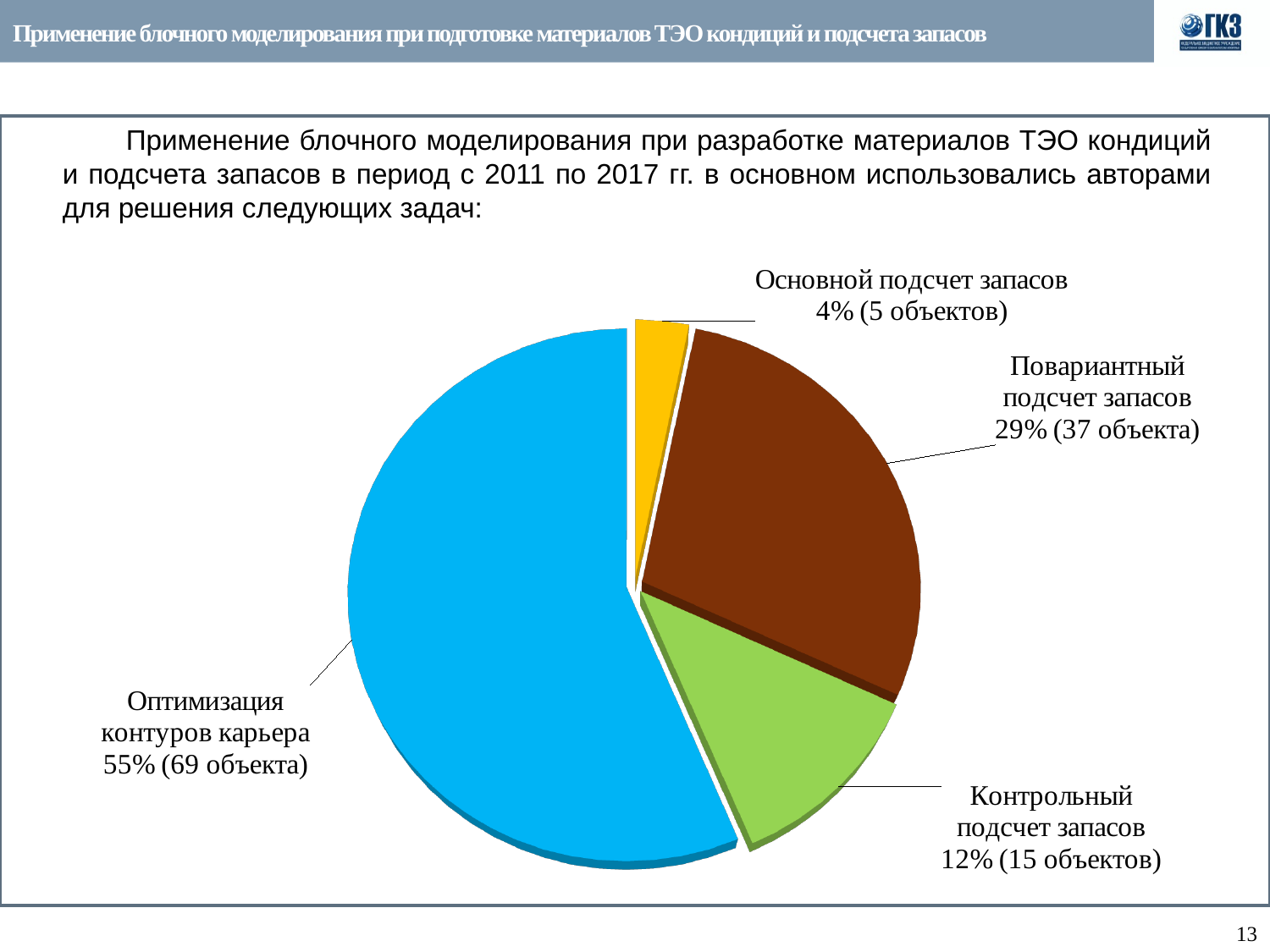
What share of the pie does "Оптимизация контуров карьера" take? 55% What share of the pie does "Повариантный подсчет запасов" take? 29% How many objects are given for "Повариантный подсчет запасов"? 37 How many slices does the pie chart have? 4 What share of the pie does "Контрольный подсчет запасов" take? 12% How many objects are given for "Оптимизация контуров карьера"? 69 What kind of chart is shown on the slide? Pie chart Which category has the smallest slice of the pie? Основной подсчет запасов Which slice is larger: "Контрольный подсчет запасов" or "Основной подсчет запасов"? Контрольный подсчет запасов Which category has the largest slice of the pie? Оптимизация контуров карьера What is the difference in percentage points between "Повариантный подсчет запасов" and "Контрольный подсчет запасов"? 17